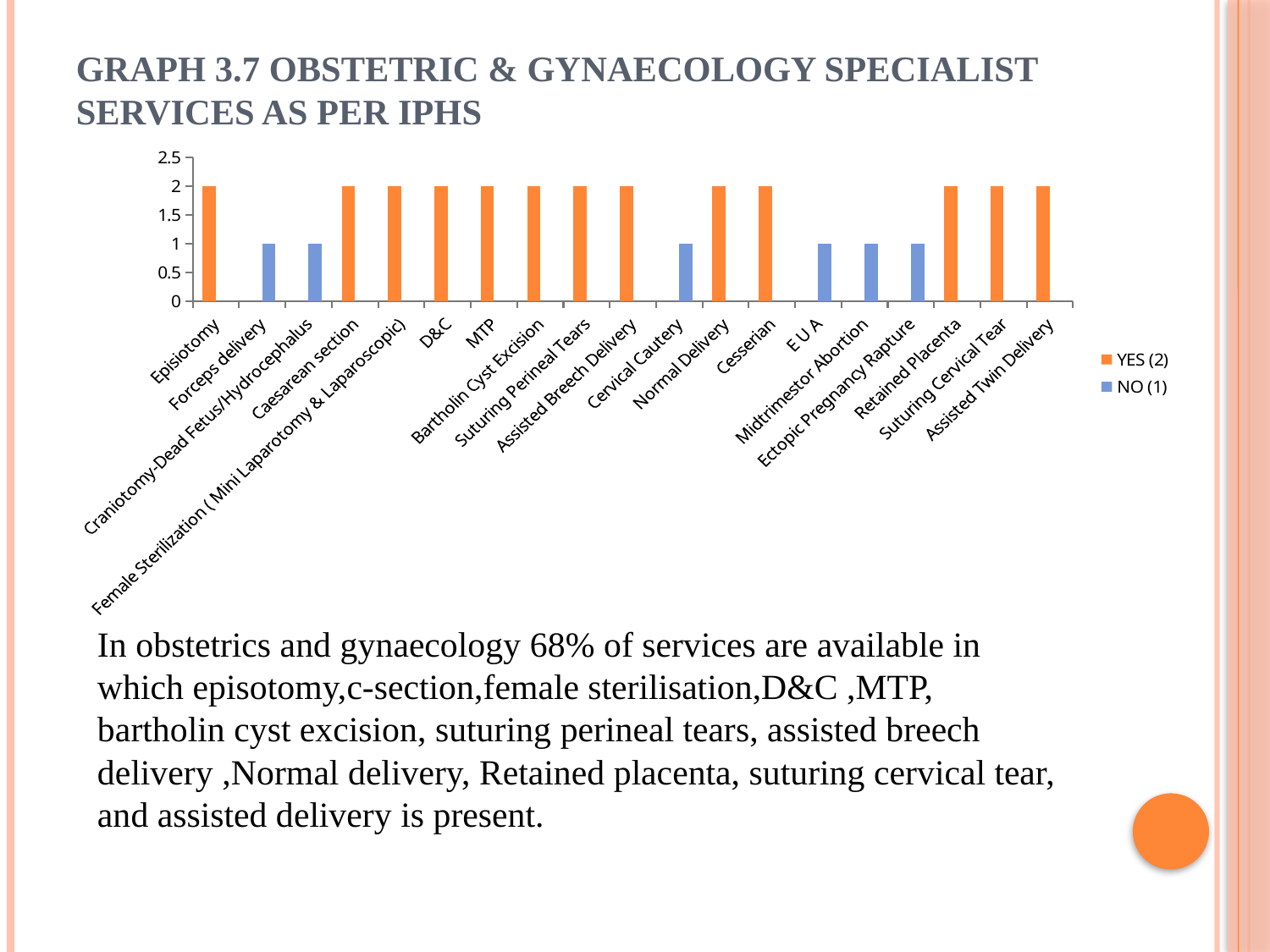
Which legend entry is shown in orange? YES (2) How many categories are plotted along the x axis? 19 How many series does the legend list? 2 Is the value for Ectopic Pregnancy Rapture greater or less than 1.5? less Which is larger, the value for D&C or the value for E U A? D&C What is the value of the bar for Cervical Cautery? 1 How many categories have a blue (NO) bar? 6 What is the value of the bar for Forceps delivery? 1 What kind of chart is shown on the slide? Bar chart What is the difference between the value for Normal Delivery and the value for Midtrimestor Abortion? 1 What is the value of the bar for Retained Placenta? 2 What is the value of the bar for Episiotomy? 2